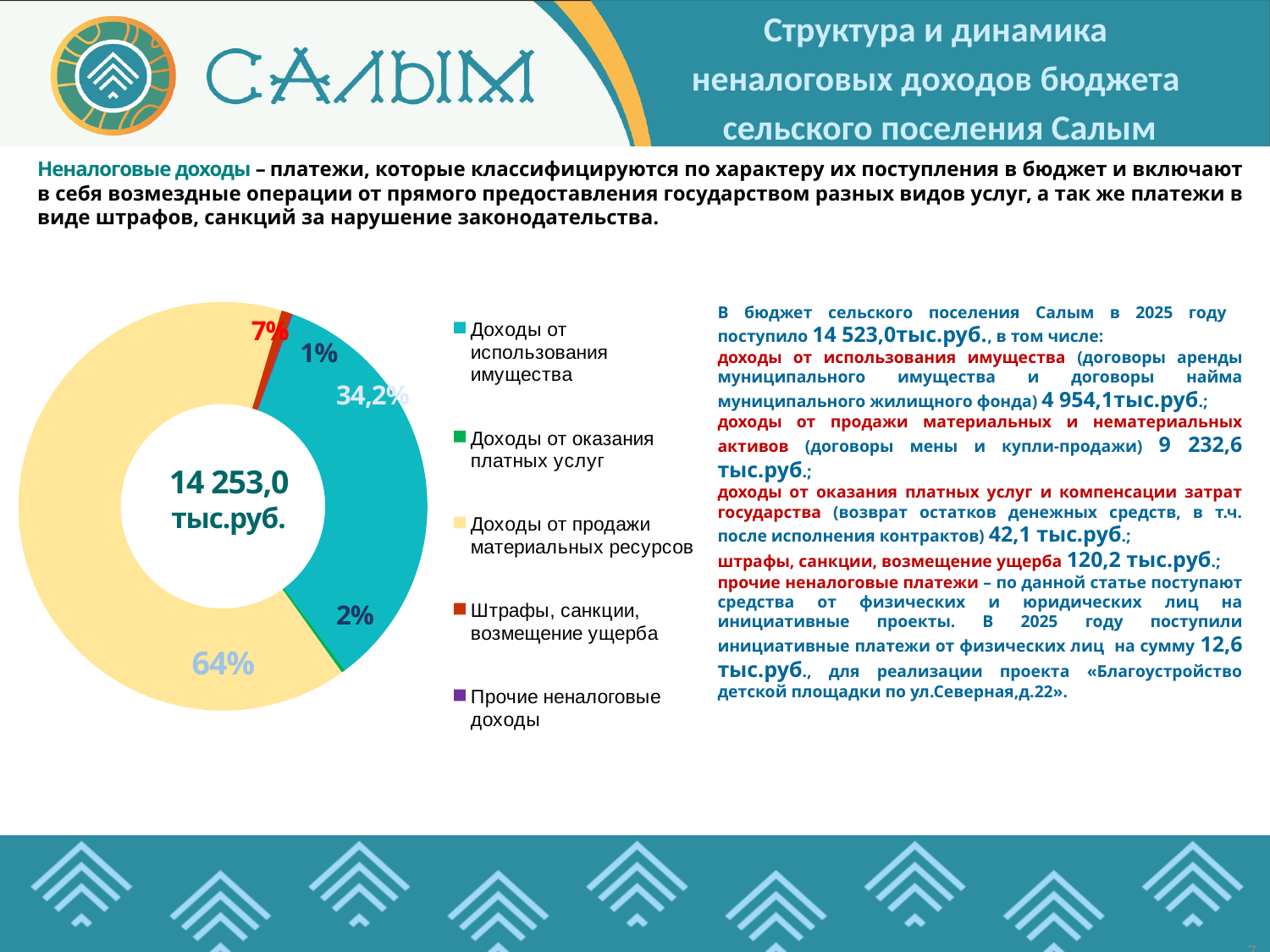
Is the share of 'Доходы от использования имущества' greater or less than 50%? less Which slice is larger: 'Доходы от продажи материальных ресурсов' or 'Доходы от использования имущества'? Доходы от продажи материальных ресурсов What percentage is shown for the slice 'Доходы от продажи материальных ресурсов'? 64% Which legend entry is shown in teal (blue-green)? Доходы от использования имущества What colour is the 'Доходы от продажи материальных ресурсов' slice in the chart? Yellow Which legend category has the largest slice of the chart? Доходы от продажи материальных ресурсов What total value is printed in the centre of the doughnut chart? 14 253,0 тыс.руб. By how many percentage points does the 'Доходы от продажи материальных ресурсов' slice exceed the 'Доходы от использования имущества' slice? 29,8% How many entries does the chart legend list? 5 What kind of chart is shown on the slide? Pie (doughnut) chart What percentage is shown for the slice 'Доходы от использования имущества'? 34,2%